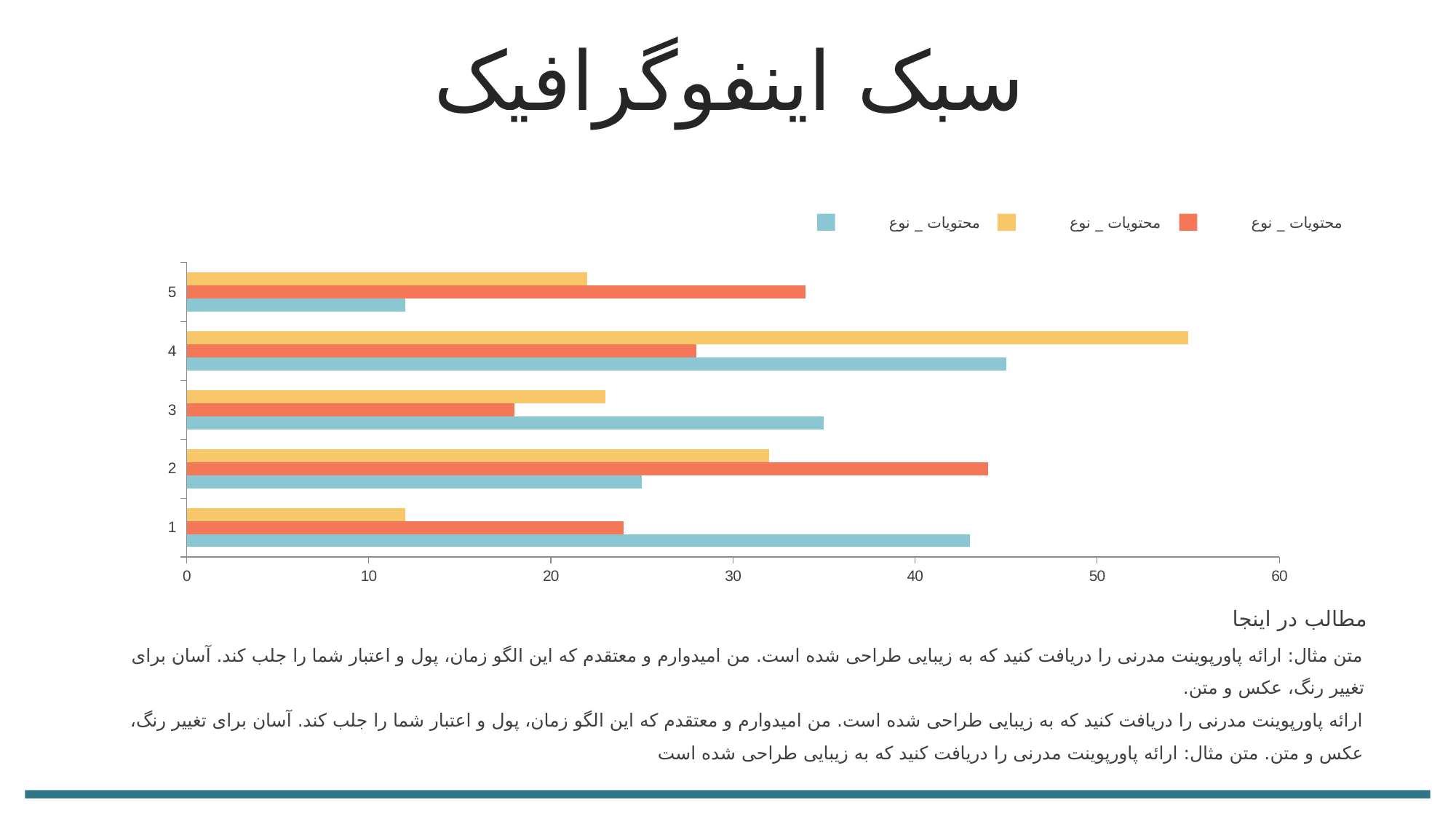
Which category has the shortest orange bar? 3 Is the value of the yellow bar for category 1 greater or less than 20? less How many series does the chart's legend list? 3 What is the highest value shown on the horizontal axis of the chart? 60 Is the value of the orange bar for category 2 greater or less than 40? greater Which category has the longest yellow bar? 4 How many categories are shown on the vertical axis of the chart? 5 What kind of chart is shown on the slide? bar chart Which category has the shortest blue bar? 5 Is the value of the yellow bar for category 4 greater or less than 50? greater For category 1, which is larger: the blue bar or the orange bar? the blue bar